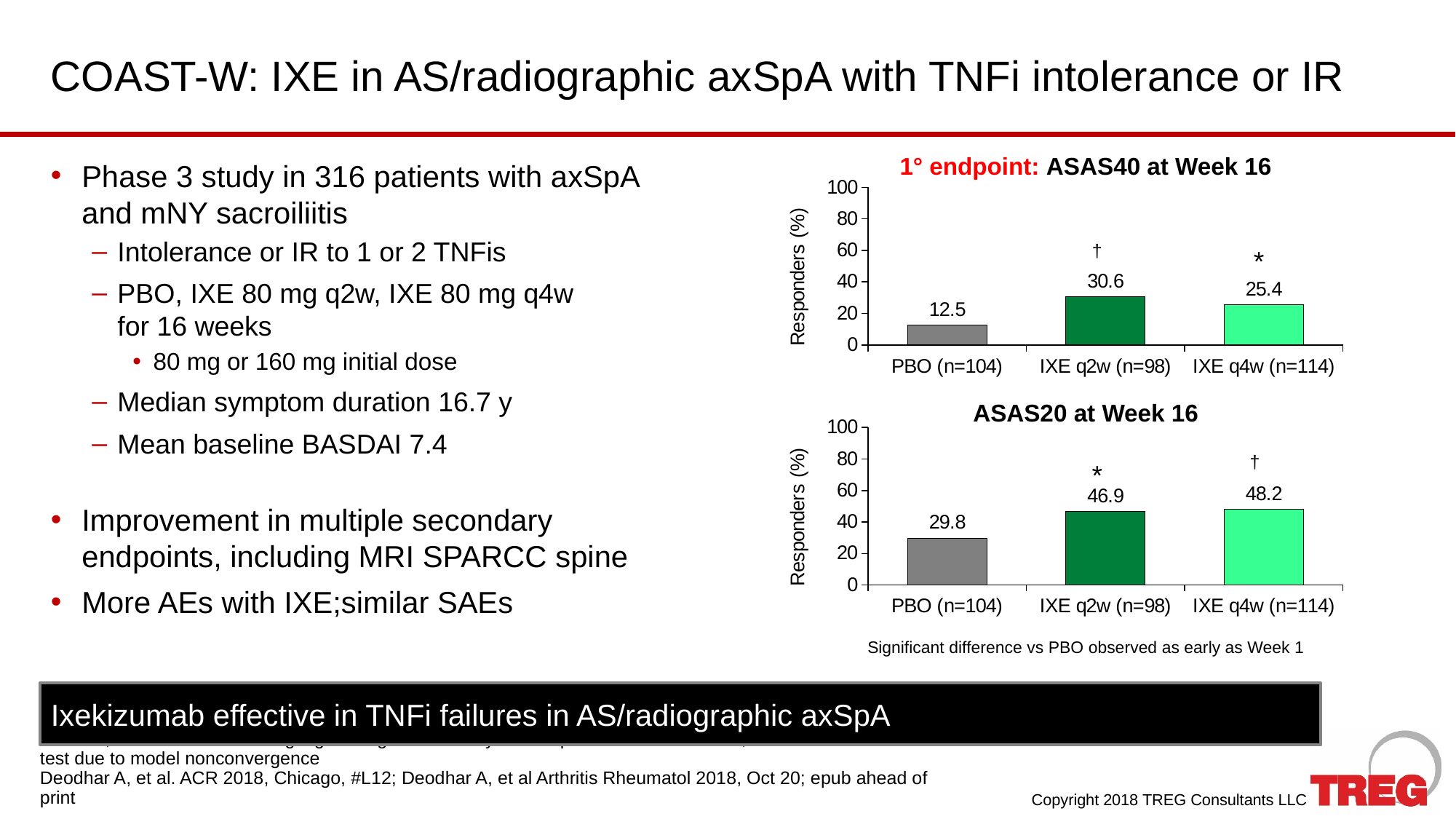
How many categories are shown in the ASAS40 at Week 16 chart? 3 In the ASAS20 at Week 16 chart, what is the value for IXE q4w (n=114)? 48.2 What kind of chart is the ASAS20 at Week 16 chart? Bar chart In the ASAS20 at Week 16 chart, which category has the lowest value? PBO (n=104) In the ASAS20 at Week 16 chart, what is the value for PBO (n=104)? 29.8 In the ASAS20 at Week 16 chart, is the value for IXE q2w (n=98) greater or less than 40? greater In the ASAS40 at Week 16 chart, what is the difference between IXE q2w (n=98) and PBO (n=104)? 18.1 In the ASAS40 at Week 16 chart, what is the value for PBO (n=104)? 12.5 In the ASAS20 at Week 16 chart, what is the difference between IXE q4w (n=114) and IXE q2w (n=98)? 1.3 In the ASAS40 at Week 16 chart, what is the value for IXE q2w (n=98)? 30.6 In the ASAS40 at Week 16 chart, which is larger, IXE q2w (n=98) or IXE q4w (n=114)? IXE q2w (n=98) In the ASAS40 at Week 16 chart, which category has the highest value? IXE q2w (n=98)